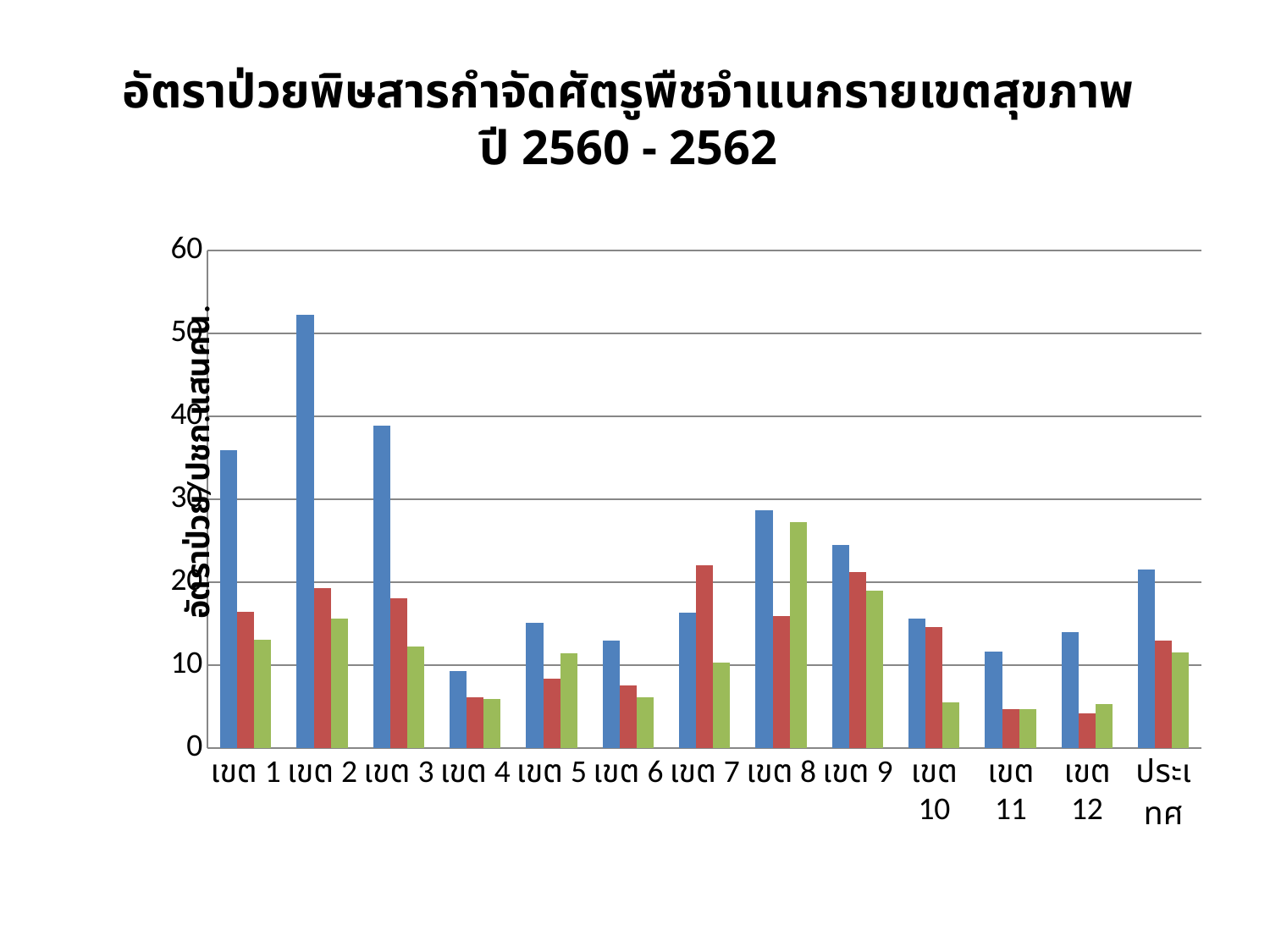
How many data series (bars per category) does the chart plot? 3 Is the blue bar for เขต 3 greater or less than 40? less Is the blue bar for เขต 4 greater or less than 10? less For เขต 7, which is larger: the red bar or the green bar? the red bar Which category has the tallest blue bar? เขต 2 Is the red bar for เขต 12 greater or less than 10? less How many categories are shown along the x axis of the chart? 13 Which is larger: the blue bar for เขต 8 or the blue bar for เขต 9? เขต 8 Which category has the tallest green bar? เขต 8 What kind of chart is shown on the slide? bar chart